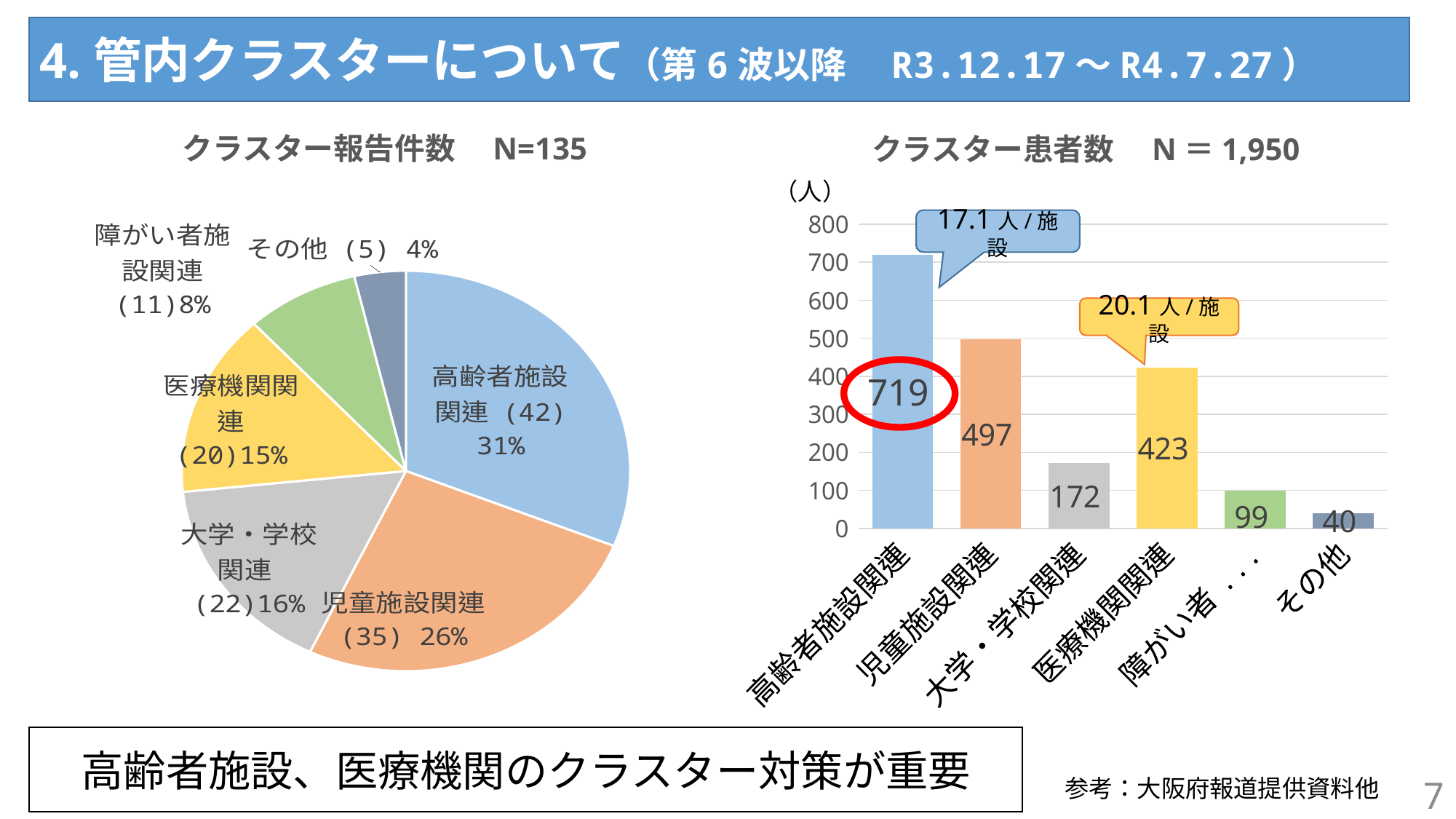
In the pie chart クラスター報告件数, how many reports are shown for 医療機関関連? 20 In the bar chart クラスター患者数, what is the difference between 児童施設関連 and 大学・学校関連? 325 In the bar chart クラスター患者数, what is the value for 医療機関関連? 423 In the pie chart クラスター報告件数, which category has the largest slice? 高齢者施設関連 What kind of chart is the chart titled クラスター患者数? bar chart What is the N value shown in the title of the pie chart クラスター報告件数? N=135 In the pie chart クラスター報告件数, what share does 児童施設関連 have? 26% In the bar chart クラスター患者数, what is the value for 高齢者施設関連? 719 In the bar chart クラスター患者数, which is larger, 医療機関関連 or 児童施設関連? 児童施設関連 In the bar chart クラスター患者数, which category has the lowest value? その他 In the bar chart クラスター患者数, how many categories are shown? 6 In the bar chart クラスター患者数, which category has the highest value? 高齢者施設関連